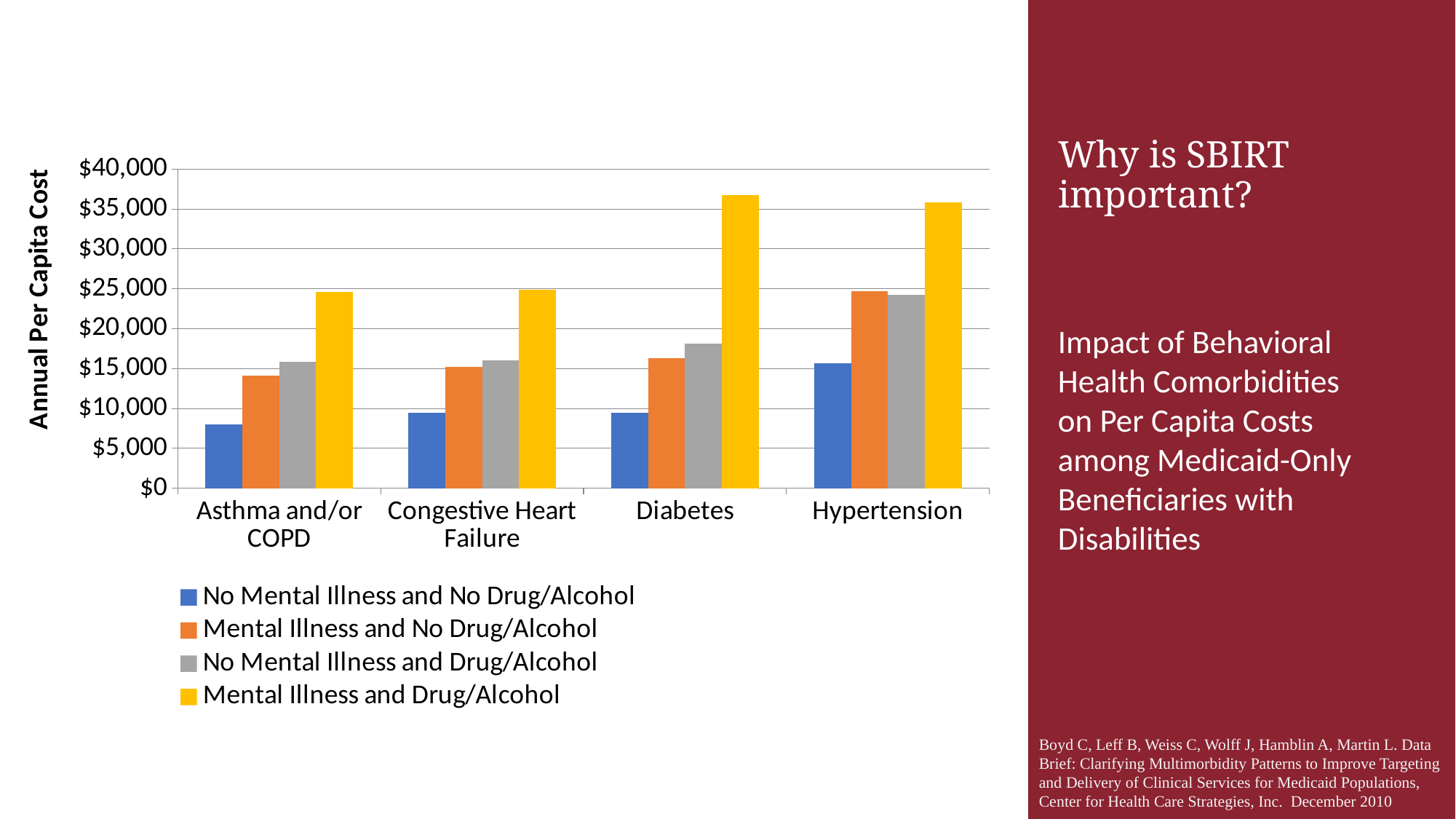
How many series does the legend list? 4 What kind of chart is shown on the slide? bar chart Which category has the highest value for Mental Illness and Drug/Alcohol? Diabetes Which is larger: the Mental Illness and Drug/Alcohol value for Diabetes or for Asthma and/or COPD? Diabetes Is the Mental Illness and No Drug/Alcohol value for Hypertension greater or less than $20,000? greater What is the title of the y axis? Annual Per Capita Cost Is the Mental Illness and Drug/Alcohol value for Diabetes greater or less than $35,000? greater Is the No Mental Illness and Drug/Alcohol value for Asthma and/or COPD greater or less than $20,000? less Which series has the highest value in every category? Mental Illness and Drug/Alcohol Which category has the lowest value for No Mental Illness and No Drug/Alcohol? Asthma and/or COPD How many condition categories are shown on the x axis? 4